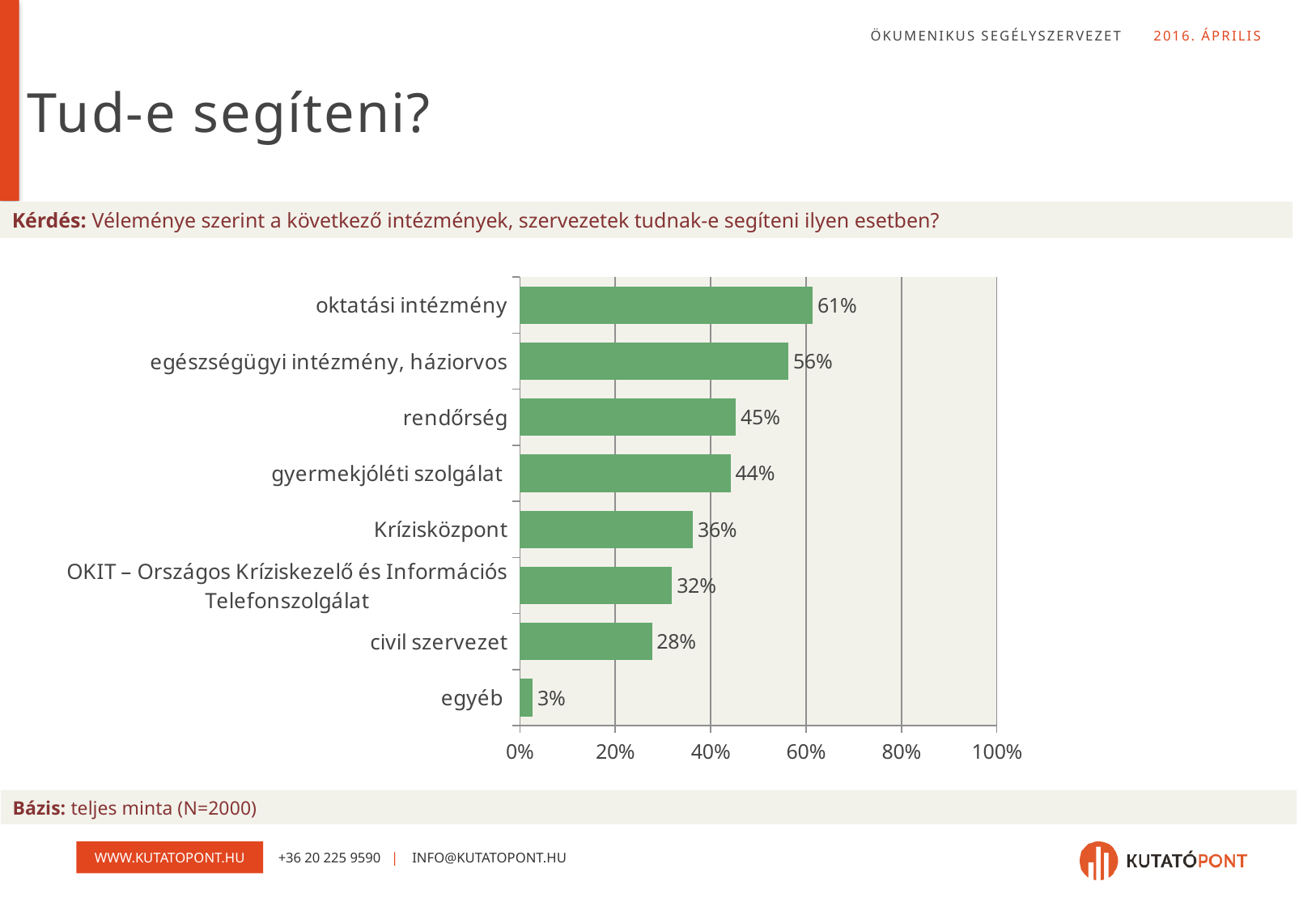
How many categories are shown in the chart? 8 What is the difference between the values for rendőrség and civil szervezet? 17% What is the value for civil szervezet? 28% Which category has the highest value? oktatási intézmény What is the value for oktatási intézmény? 61% What is the value for rendőrség? 45% Is the value for gyermekjóléti szolgálat greater or less than 40%? greater Which is larger, the value for Krízisközpont or the value for OKIT – Országos Kríziskezelő és Információs Telefonszolgálat? Krízisközpont What is the highest value shown on the x axis? 100% Which category has the lowest value? egyéb What kind of chart is shown on the slide? bar chart What is the difference between the values for oktatási intézmény and egészségügyi intézmény, háziorvos? 5%